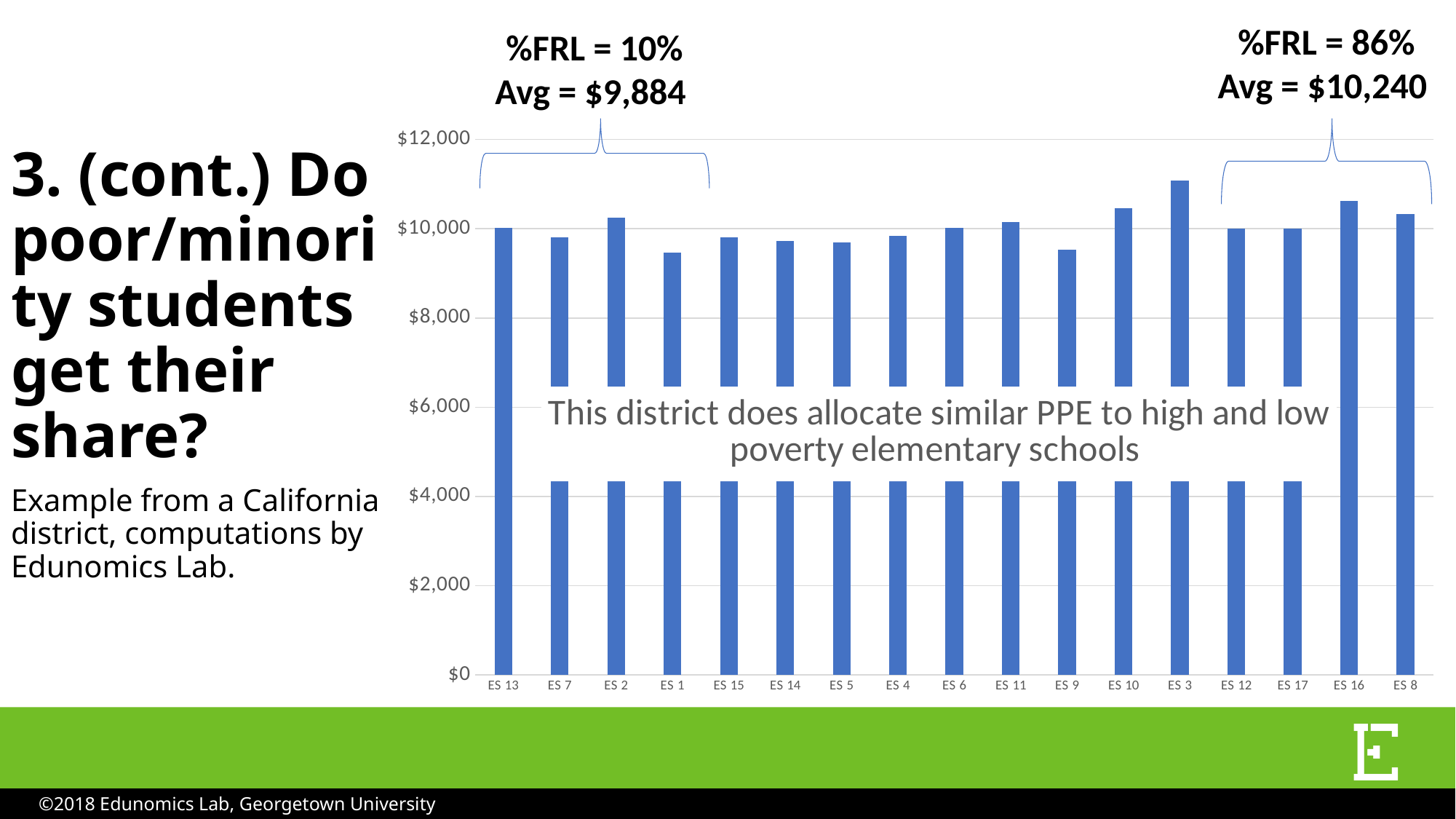
Which school has the highest per-pupil expenditure on the chart? ES 3 What kind of chart is shown on the slide? bar chart Is the value for ES 3 greater or less than $10,000? greater Which is larger, the value for ES 3 or the value for ES 1? ES 3 Is the value for ES 1 greater or less than $10,000? less According to the annotation above the chart, what is the average for the group with %FRL = 86%? $10,240 According to the annotation above the chart, what is the average for the group with %FRL = 10%? $9,884 Which is larger, the value for ES 16 or the value for ES 9? ES 16 Is the value for ES 9 greater or less than $10,000? less How many schools (bars) are plotted on the chart? 17